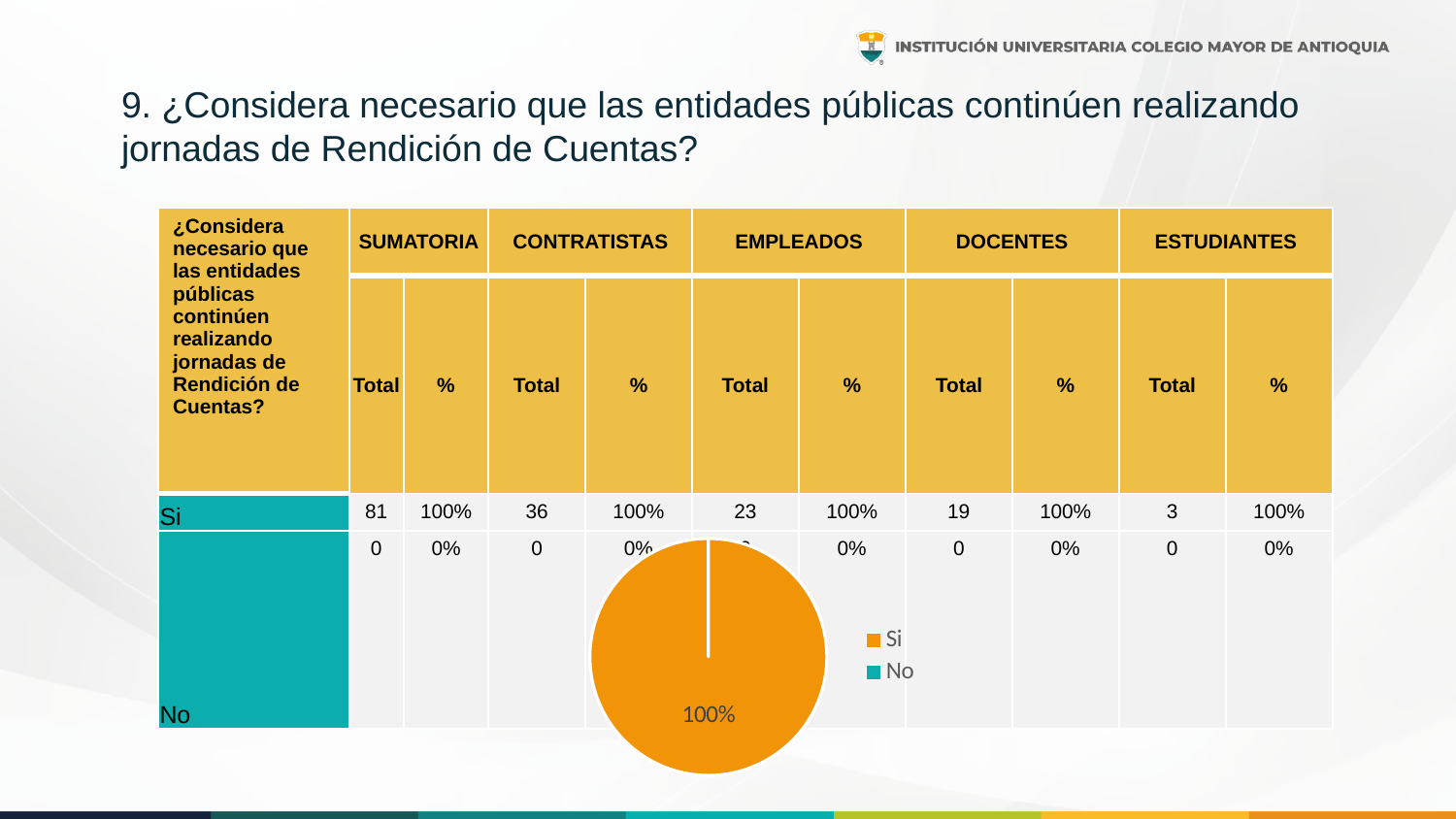
Which category has the smallest share in the pie chart? No Which category has the largest slice in the pie chart? Si Which is larger in the pie chart, the share for "Si" or the share for "No"? Si What share of the pie chart does the "Si" slice take? 100% What colour is the "Si" slice in the pie chart? orange What kind of chart is shown on the slide? pie chart What are the two categories listed in the pie chart's legend? Si and No How many entries does the pie chart's legend list? 2 What percentage is shown as the data label on the pie chart? 100%